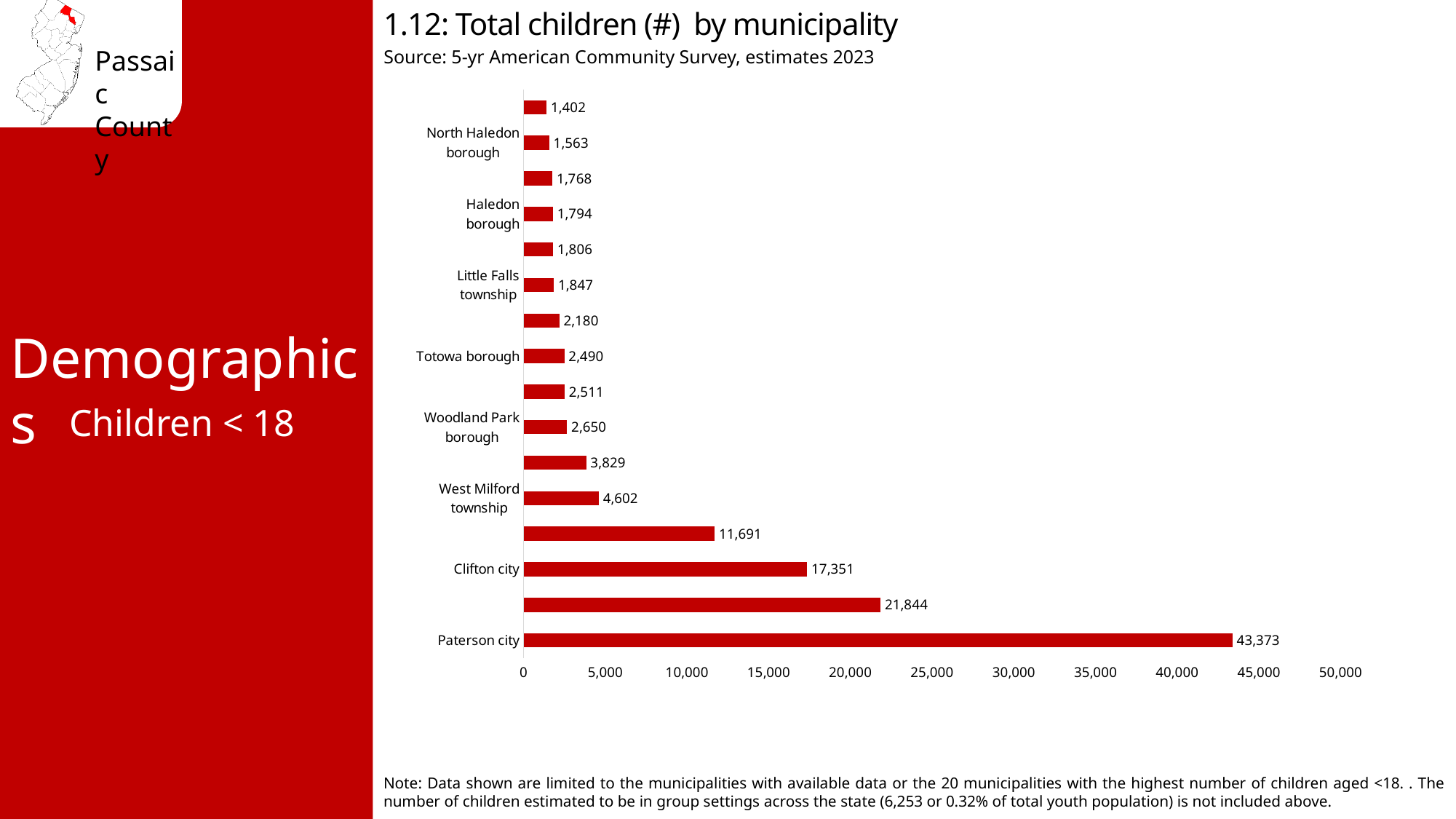
What is the total number of children for West Milford township? 4,602 What is the title of the chart? 1.12: Total children (#) by municipality Which has more children, Totowa borough or Woodland Park borough? Woodland Park borough What is the difference in the number of children between Paterson city and Clifton city? 26,022 What is the total number of children for North Haledon borough? 1,563 What type of chart is shown on the slide? bar chart Which municipality has the highest number of children? Paterson city What is the total number of children for Clifton city? 17,351 How many bars are plotted in the chart? 16 Is the value for Clifton city greater or less than 15,000? greater What is the total number of children for Paterson city? 43,373 What is the total number of children for Woodland Park borough? 2,650